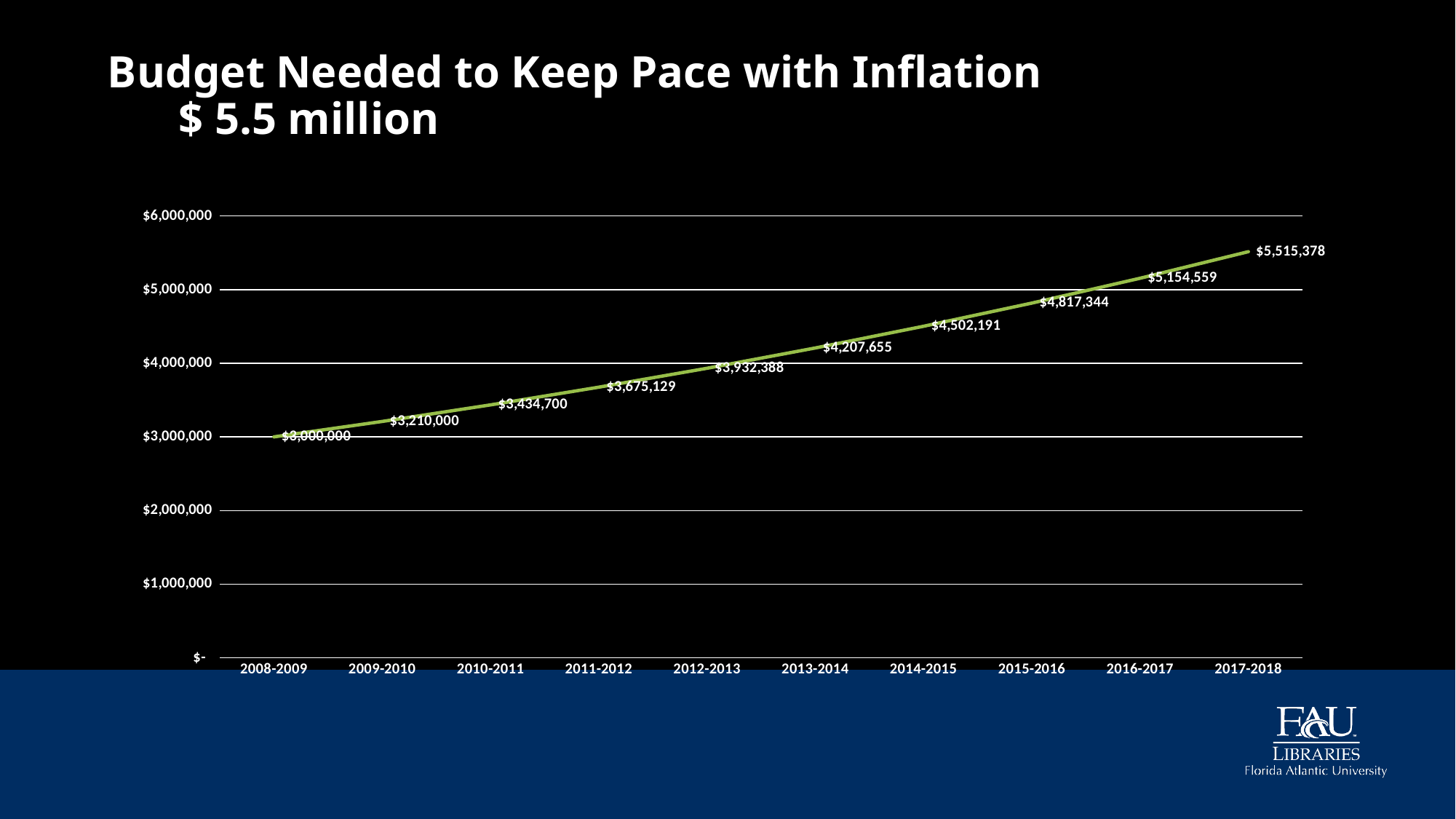
Do the values rise or fall from 2008-2009 to 2017-2018? Rise What is the difference between the 2009-2010 value and the 2008-2009 value? $210,000 What kind of chart is shown on the slide? Line chart What is the difference between the 2017-2018 value and the 2008-2009 value? $2,515,378 What is the budget value shown for 2012-2013? $3,932,388 What is the budget value shown for 2008-2009? $3,000,000 Which year has the lowest budget value on the chart? 2008-2009 What is the budget value shown for 2017-2018? $5,515,378 Which year has the highest budget value on the chart? 2017-2018 Which is larger, the value for 2013-2014 or the value for 2011-2012? 2013-2014 How many years are plotted on the x axis? 10 What is the budget value shown for 2014-2015? $4,502,191